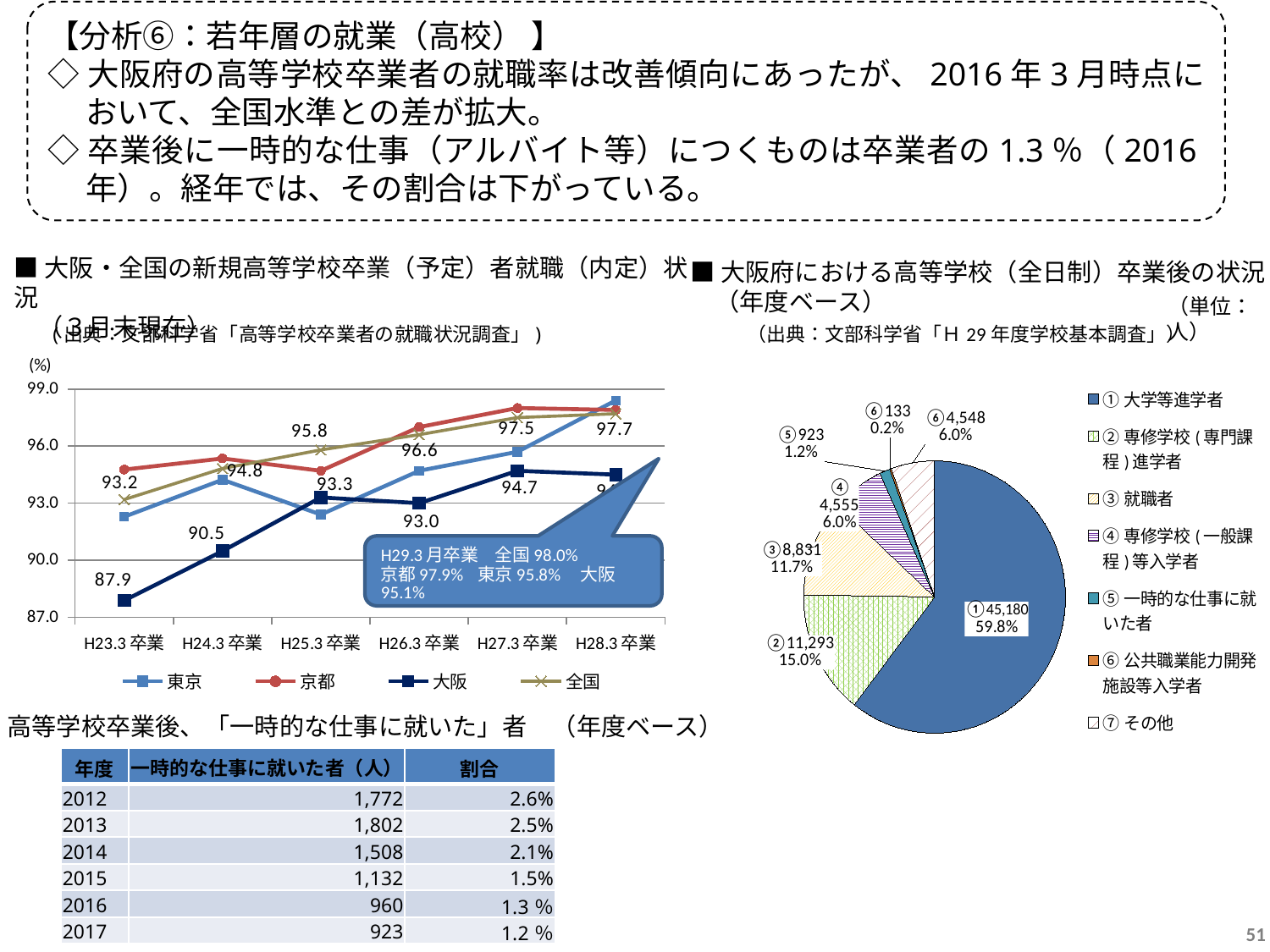
In the left line chart, at which x-axis category is the 大阪 series lowest? H23.3卒業 In the left line chart, what is the value for 大阪 at H23.3卒業? 87.9 In the left line chart, how many x-axis categories are plotted? 6 In the left line chart, does the 全国 series rise or fall from H23.3卒業 to H28.3卒業? rise What kind of chart is the right chart (大阪府における高等学校（全日制）卒業後の状況)? pie chart In the right pie chart, what is the value for ③就職者? 8,831 In the left line chart, how many series does the legend list? 4 What kind of chart is the left chart (大阪・全国の新規高等学校卒業（予定）者就職（内定）状況)? line chart In the left line chart, what is the value for 全国 at H25.3卒業? 95.8 In the left line chart, is the value for 東京 at H23.3卒業 greater or less than 93.0? less In the right pie chart, what share does ①大学等進学者 have? 59.8% In the left line chart, what is the difference between 全国 and 大阪 at H23.3卒業? 5.3